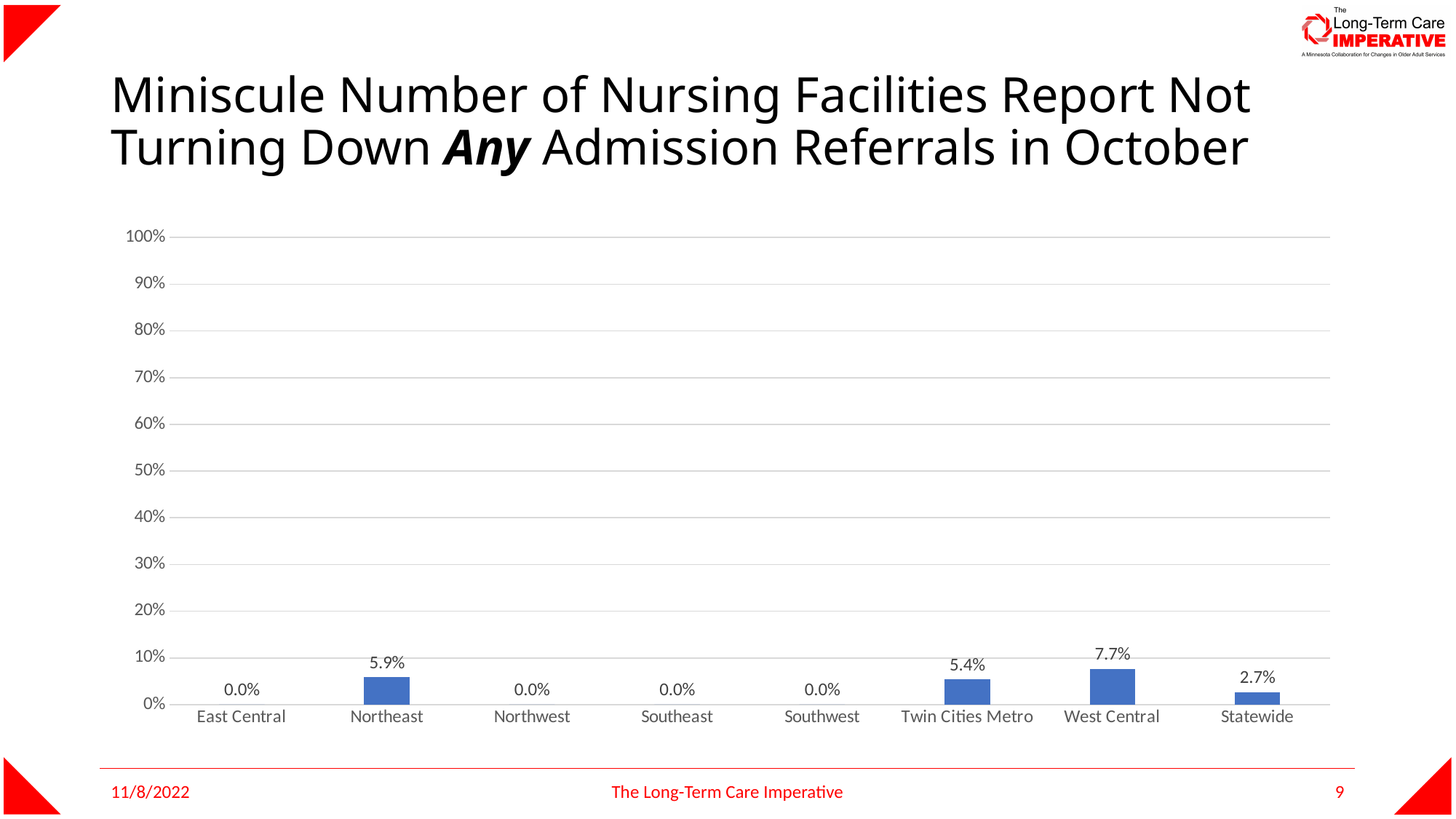
Is the value for West Central greater or less than 10%? less What kind of chart is shown on the slide? bar chart What is the difference between the values for Twin Cities Metro and Statewide? 2.7% What is the value for Twin Cities Metro? 5.4% Which region has the highest value? West Central What is the value for Northeast? 5.9% Which is larger, the value for Northeast or the value for Twin Cities Metro? Northeast How many categories have a value of 0.0%? 4 What is the value for West Central? 7.7% What is the value for Statewide? 2.7% What is the difference between the values for West Central and Northeast? 1.8% How many categories are shown on the x axis? 8